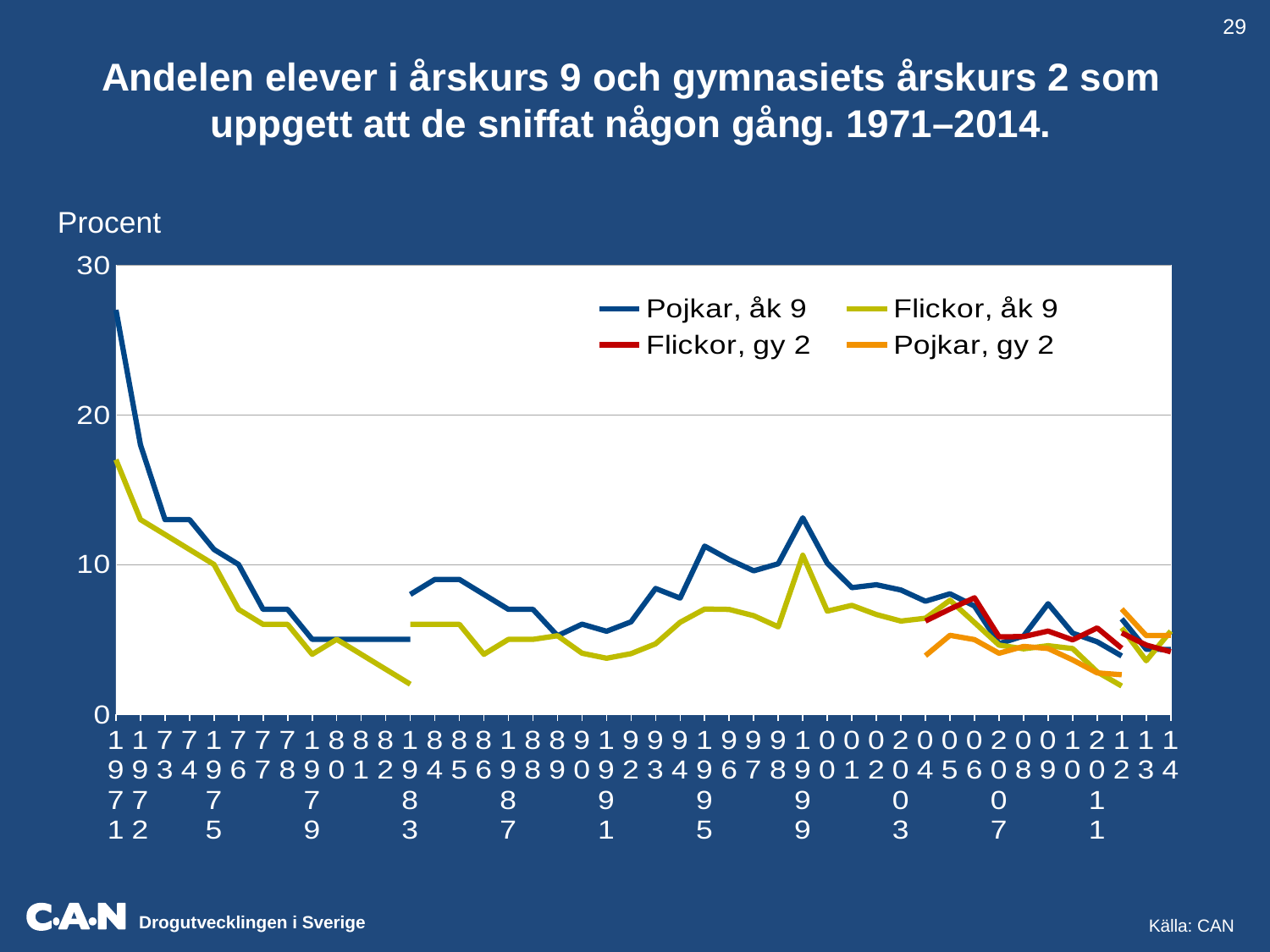
What is the highest value shown on the vertical axis? 30 In 1971, which is larger: the value for Pojkar, åk 9 or the value for Flickor, åk 9? Pojkar, åk 9 Is the value for Pojkar, åk 9 in 1971 greater or less than 20? greater Is the value for Flickor, åk 9 in 1971 greater or less than 20? less What colour is the line for Pojkar, gy 2 in the legend? Orange How many series does the legend list? 4 Does the Pojkar, åk 9 line rise or fall between 1971 and 1983? Fall What is the label on the vertical axis of the chart? Procent Which series has the highest value in 1971? Pojkar, åk 9 Is the value for Flickor, åk 9 in 1971 greater or less than 10? greater What kind of chart is shown on the slide? Line chart